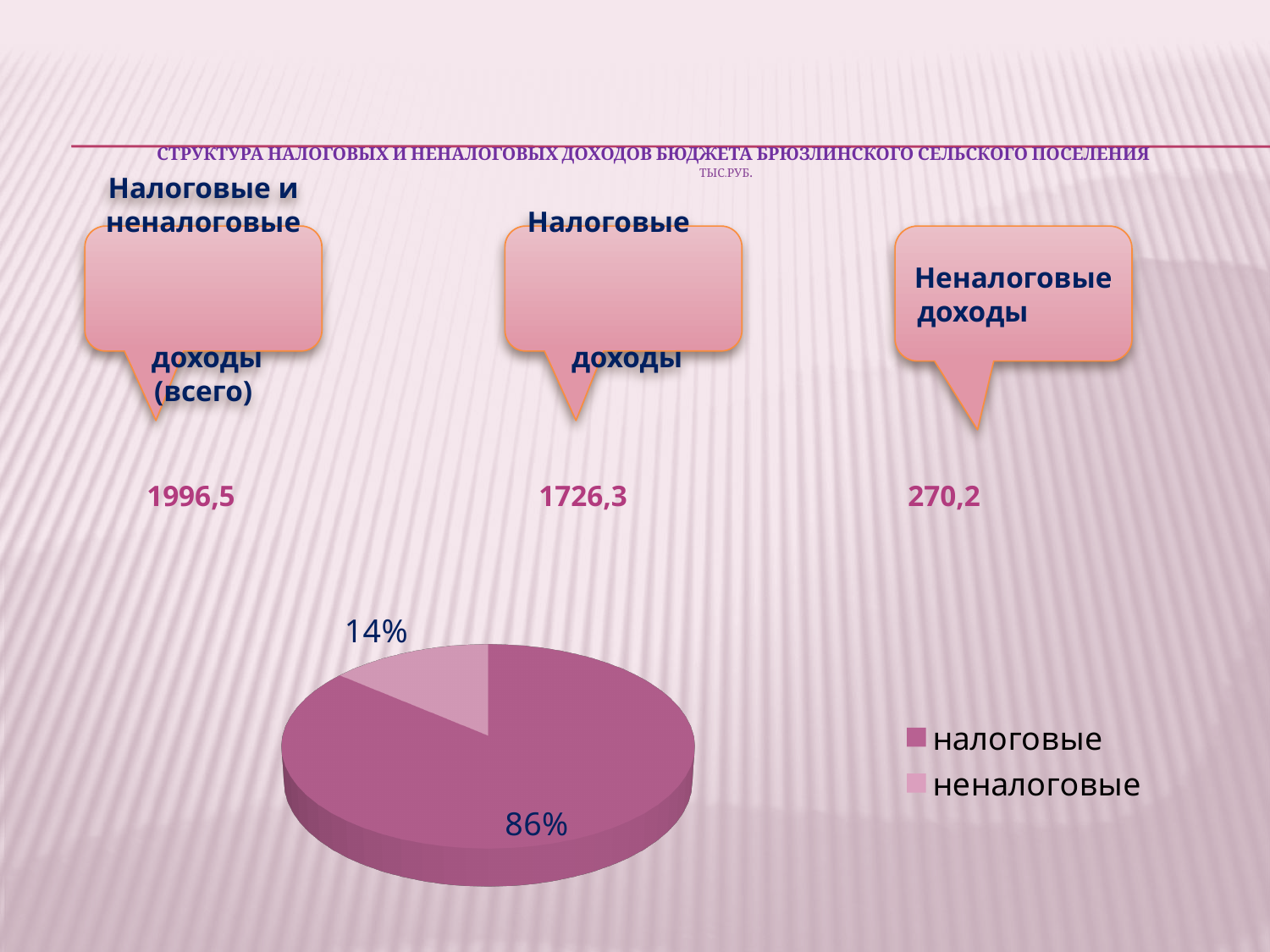
Which slice of the pie chart is the largest? налоговые How many slices does the pie chart have? 2 What is the difference in percentage points between the "налоговые" and "неналоговые" slices of the pie chart? 72 What is the total of the two slices shown in the pie chart? 100% What kind of chart is shown on the slide? pie chart What share of the pie chart does the "неналоговые" slice represent? 14% How many entries does the pie chart's legend list? 2 Which slice of the pie chart is the smallest? неналоговые What share of the pie chart does the "налоговые" slice represent? 86% Which is larger in the pie chart: "налоговые" or "неналоговые"? налоговые Which legend entry of the pie chart is shown in the lighter pink colour? неналоговые